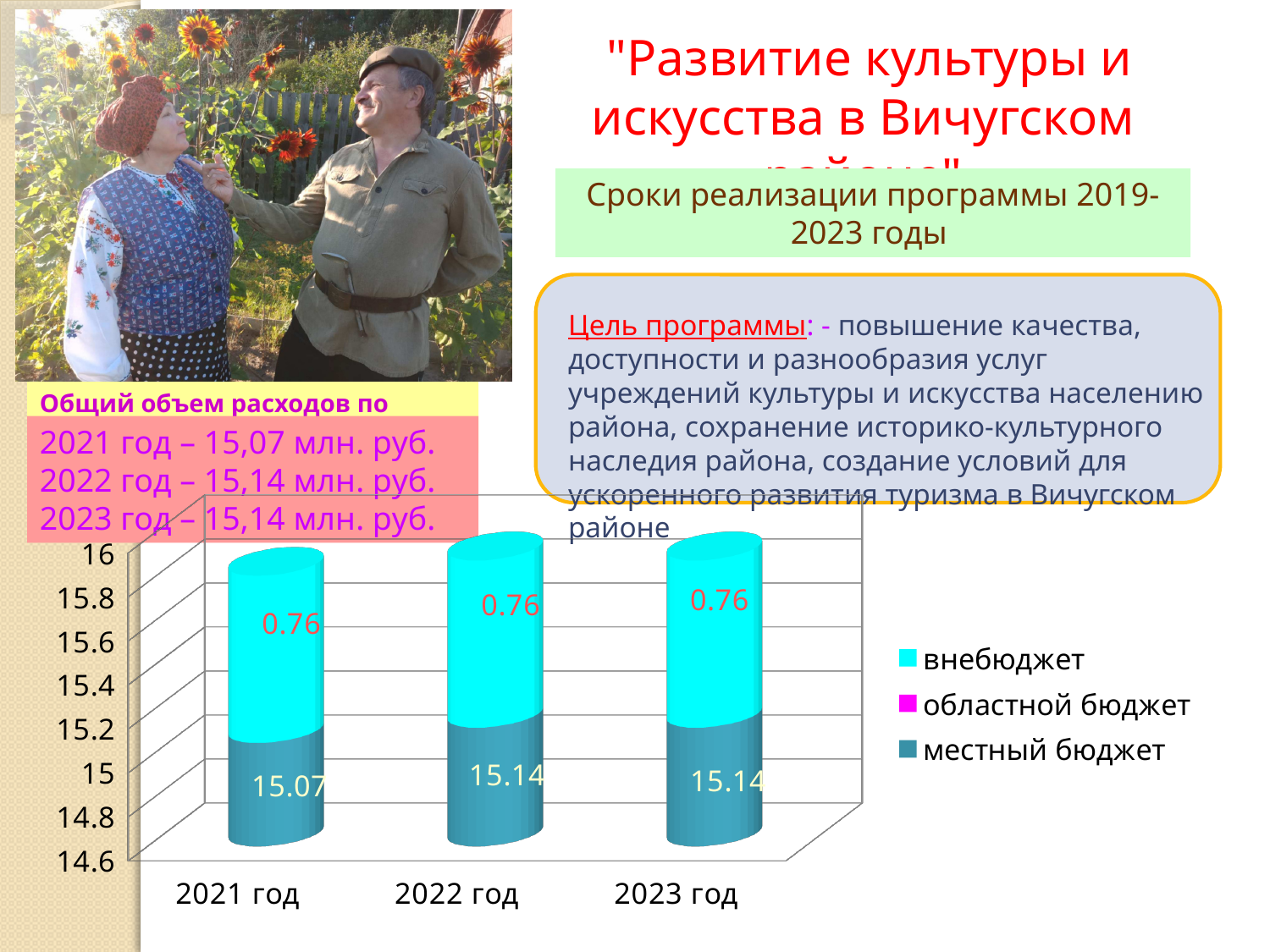
How many series does the chart legend list? 3 Which year has the lowest местный бюджет value? 2021 год What is the value of внебюджет for 2023 год? 0.76 What kind of chart is shown on the slide? Bar chart Does the местный бюджет value rise or fall from 2021 год to 2022 год? Rises What is the value of местный бюджет for 2021 год? 15.07 How many year categories are shown on the x axis of the chart? 3 What is the value of местный бюджет for 2023 год? 15.14 What is the difference between the местный бюджет values for 2022 год and 2021 год? 0.07 Which legend entry is shown in cyan (light blue)? внебюджет What is the value of внебюджет for 2022 год? 0.76 Which year has a larger местный бюджет value, 2021 год or 2022 год? 2022 год